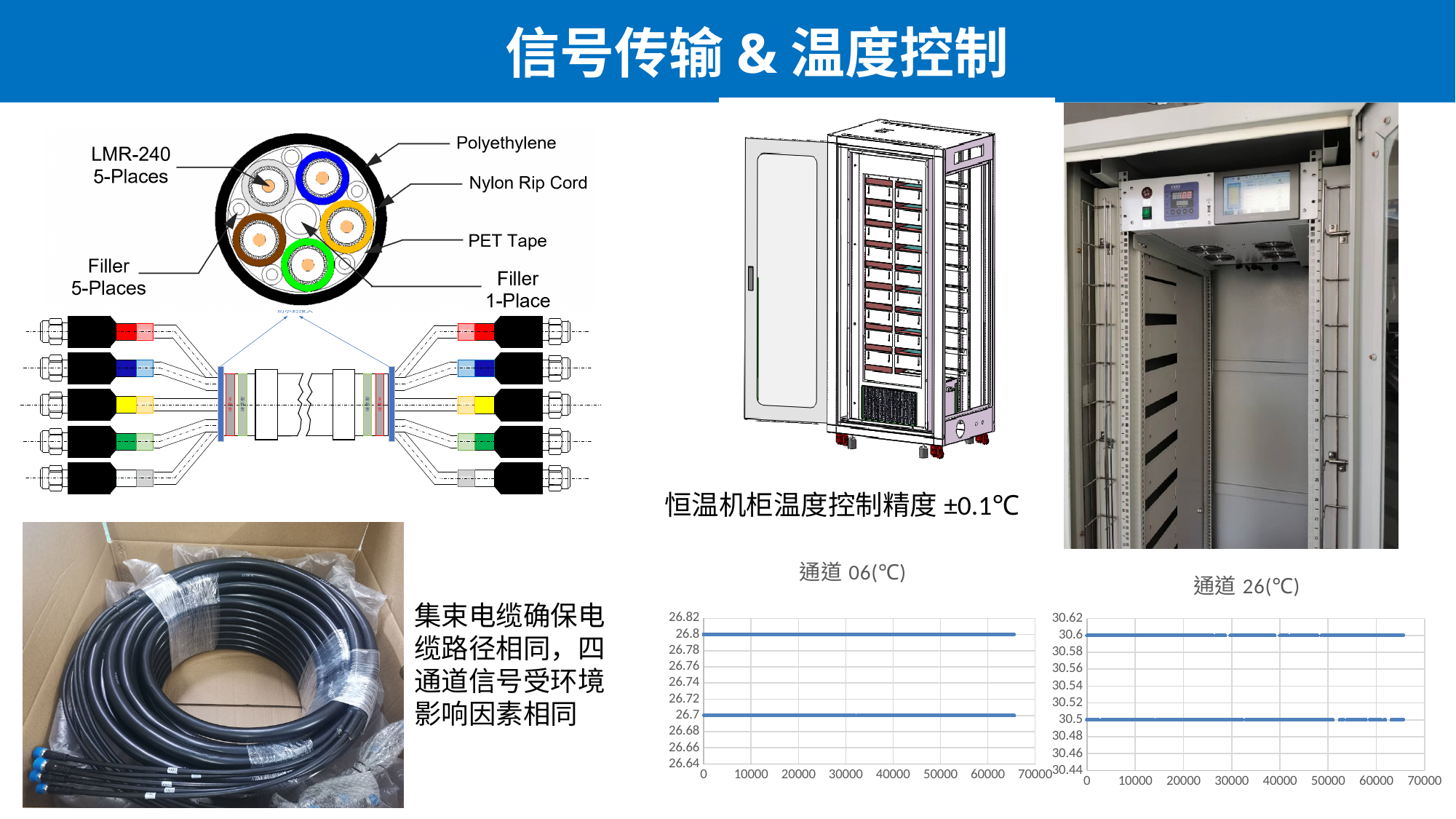
In the 通道 06(℃) chart, what is the highest value shown on the y axis? 26.82 In the 通道 06(℃) chart, do the readings rise, fall, or stay flat as the x value increases? stay flat In the 通道 26(℃) chart, what is the lowest value shown on the y axis? 30.44 In the 通道 26(℃) chart, at which two y-axis values do the plotted readings lie? 30.6 and 30.5 In the 通道 06(℃) chart, at which two y-axis values do the plotted readings lie? 26.8 and 26.7 Are the readings in the 通道 26(℃) chart higher or lower than those in the 通道 06(℃) chart? higher In the 通道 06(℃) chart, what is the difference between the upper and lower reading levels? 0.1 What is the title of the right chart at the bottom of the slide? 通道 26(℃) In the 通道 26(℃) chart, do the readings rise, fall, or stay flat as the x value increases? stay flat In the 通道 26(℃) chart, is the upper reading level greater or less than 30.58? greater